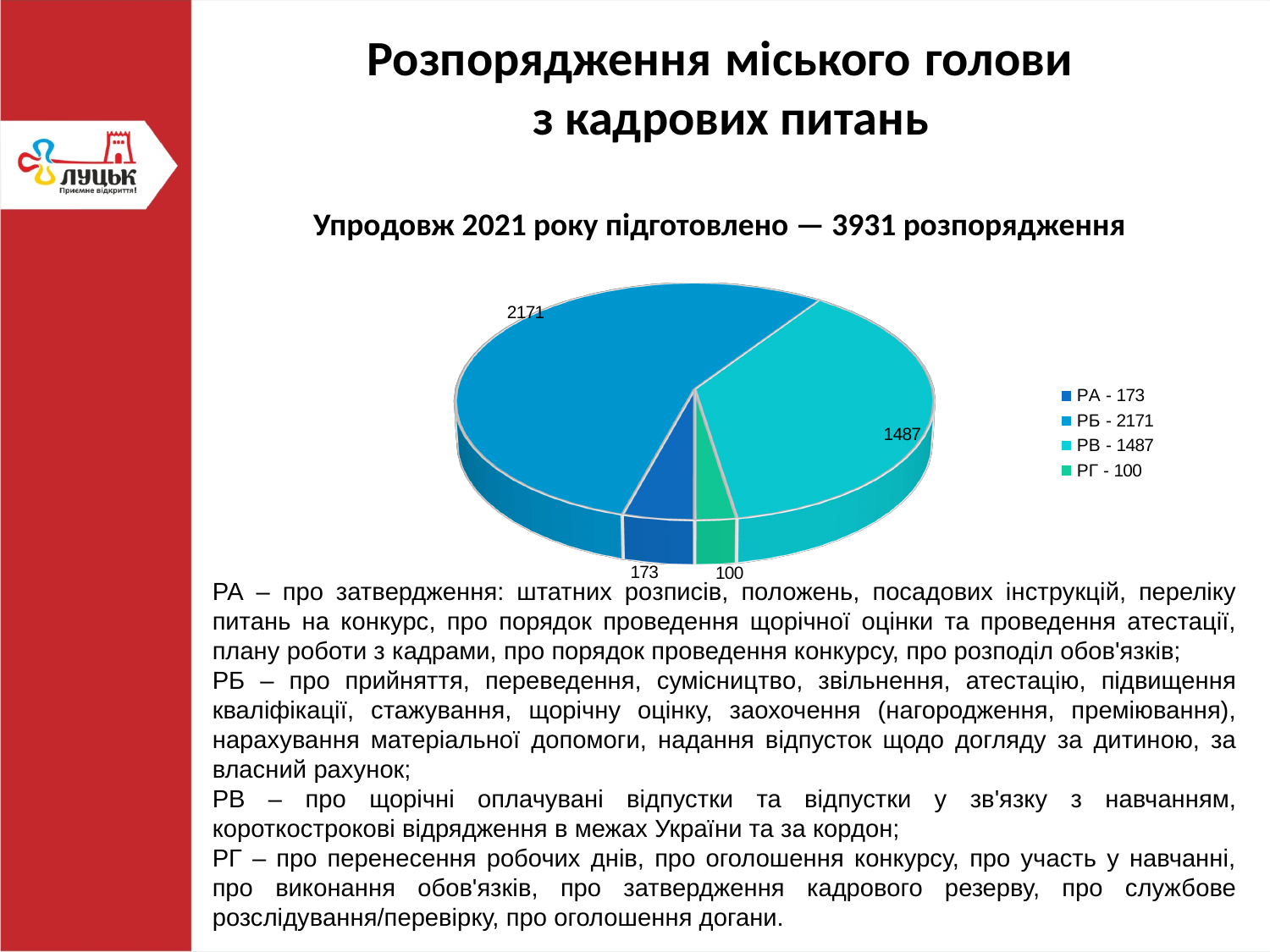
What type of chart is shown on the slide? pie chart Which is larger, the value for РА or the value for РГ? РА What is the value for РВ in the pie chart? 1487 Which category has the largest slice in the pie chart? РБ What is the value for РА in the pie chart? 173 How many slices does the pie chart have? 4 What is the value for РГ in the pie chart? 100 What is the value for РБ in the pie chart? 2171 Which category has the smallest slice in the pie chart? РГ What is the difference between the values for РБ and РВ? 684 According to the text above the chart, how many orders were prepared in 2021 in total? 3931 How many entries does the legend of the pie chart list? 4